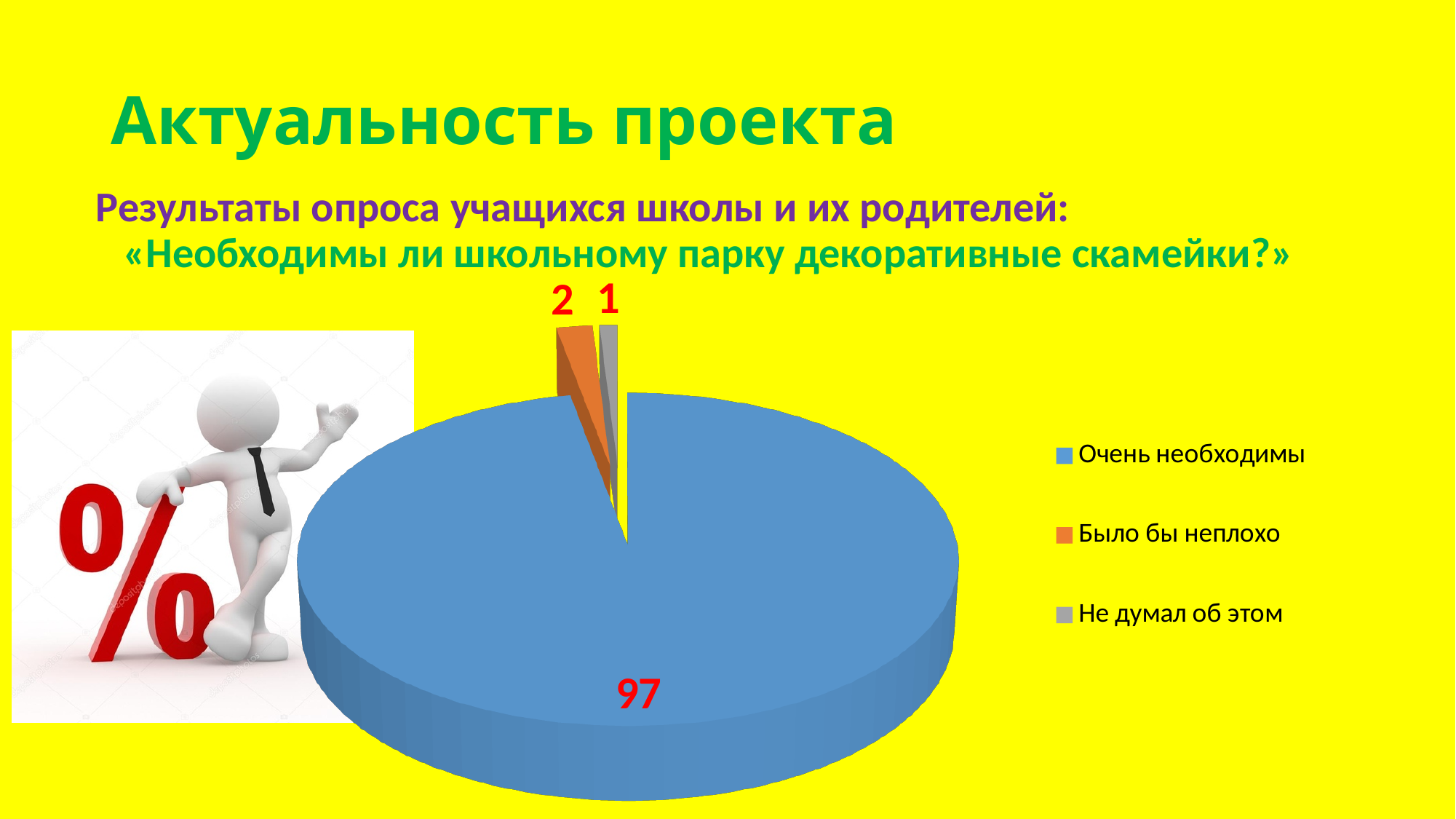
What kind of chart is shown on the slide? pie chart Which is larger, the value for "Было бы неплохо" or the value for "Не думал об этом"? Было бы неплохо How many entries does the legend list? 3 What is the value for the "Очень необходимы" slice? 97 What share of the pie does the "Очень необходимы" slice represent? 97% Which category has the largest slice of the pie? Очень необходимы What is the value for the "Было бы неплохо" slice? 2 Which category has the smallest slice of the pie? Не думал об этом What is the value for the "Не думал об этом" slice? 1 How many slices does the pie chart have? 3 What is the difference between the values for "Очень необходимы" and "Было бы неплохо"? 95 What colour is the "Было бы неплохо" slice? orange